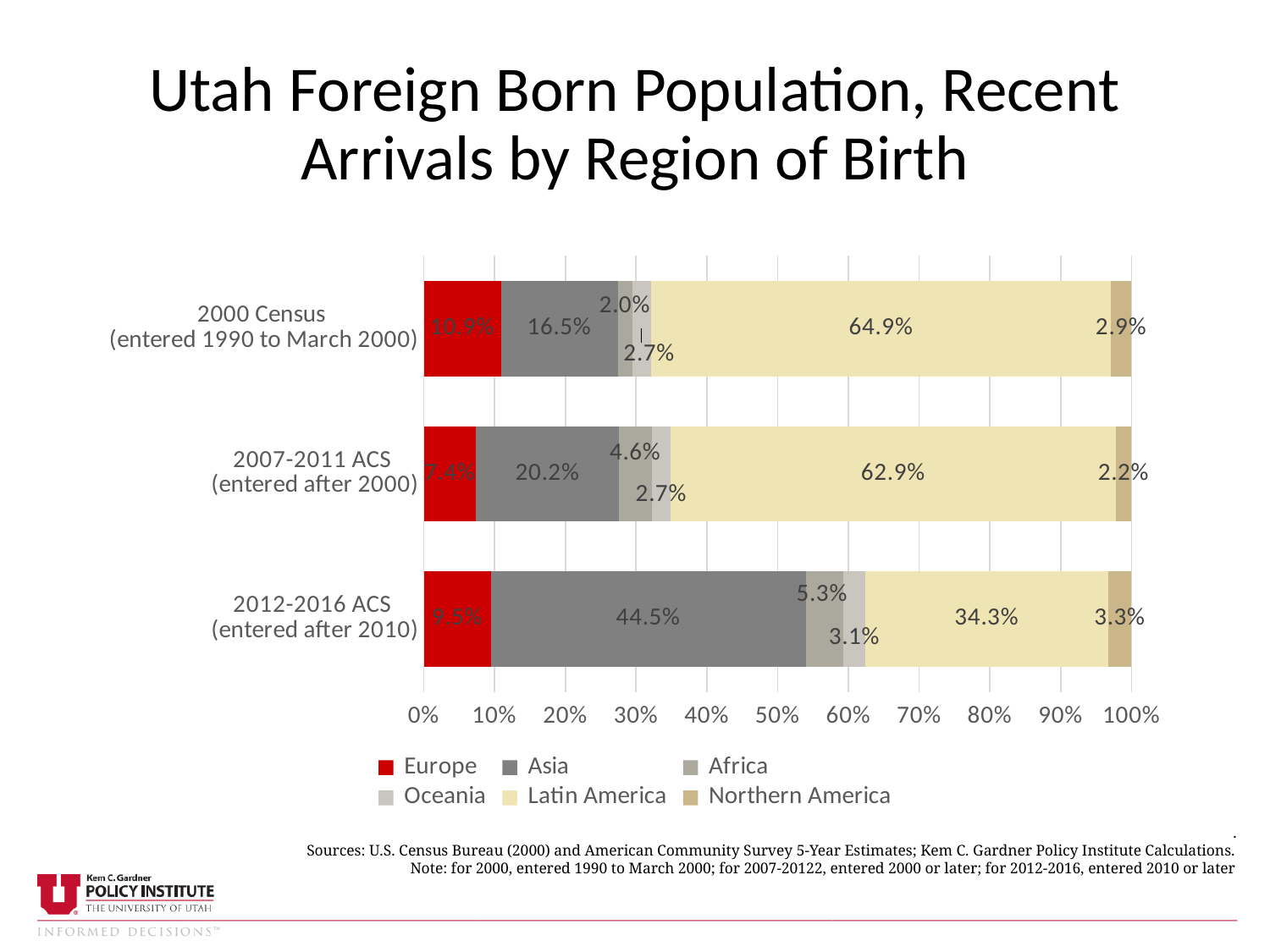
In the 2012-2016 ACS, which is larger: the Asia share or the Latin America share? Asia How many regions of birth does the legend list? 6 What is the Northern America share for the 2012-2016 ACS? 3.3% What kind of chart is shown on the slide? Stacked bar chart By how many percentage points did the Latin America share fall from the 2000 Census to the 2012-2016 ACS? 30.6 percentage points Does the Asia share rise or fall across the three periods from the 2000 Census to the 2012-2016 ACS? Rise How many time periods (categories) are plotted on the chart? 3 What is the Asia share for the 2012-2016 ACS (entered after 2010)? 44.5% What share of recent arrivals in the 2000 Census were born in Latin America? 64.9% What is the Africa share for the 2007-2011 ACS (entered after 2000)? 4.6% Which period has the lowest share of recent arrivals born in Latin America? 2012-2016 ACS (entered after 2010) Which period has the highest share of recent arrivals born in Asia? 2012-2016 ACS (entered after 2010)